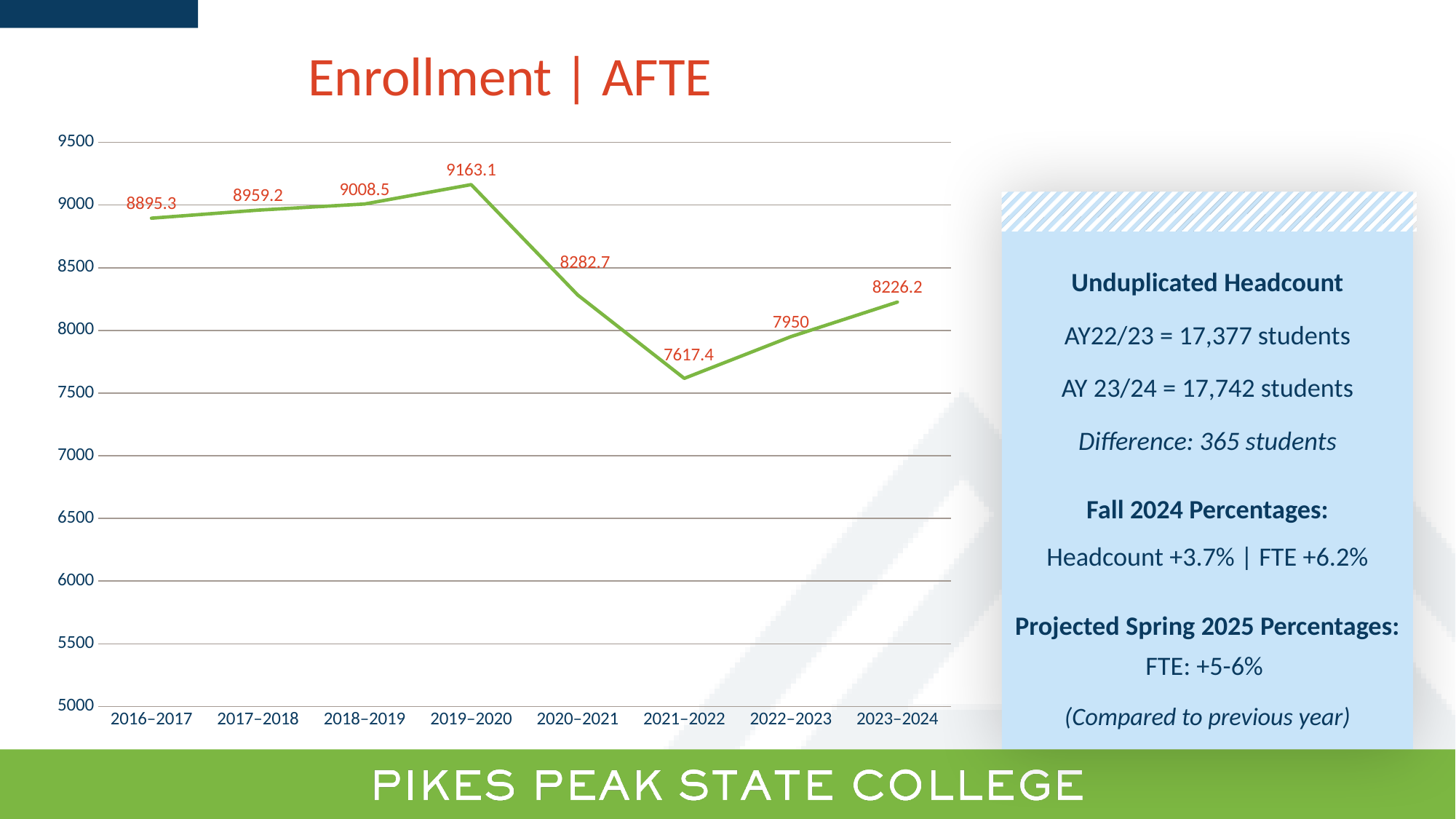
How many academic years are plotted on the chart? 8 Is the AFTE value for 2020–2021 greater or less than 8000? greater What is the difference between the AFTE values for 2019–2020 and 2021–2022? 1545.7 What is the difference between the AFTE values for 2023–2024 and 2022–2023? 276.2 What kind of chart is shown on the slide? Line chart Which academic year has the lowest AFTE value? 2021–2022 What is the AFTE value for 2021–2022? 7617.4 Which academic year has the highest AFTE value? 2019–2020 Which is larger, the AFTE value for 2016–2017 or for 2023–2024? 2016–2017 Do the AFTE values rise or fall from 2016–2017 to 2019–2020? Rise What is the AFTE value for 2019–2020? 9163.1 What is the AFTE value for 2023–2024? 8226.2